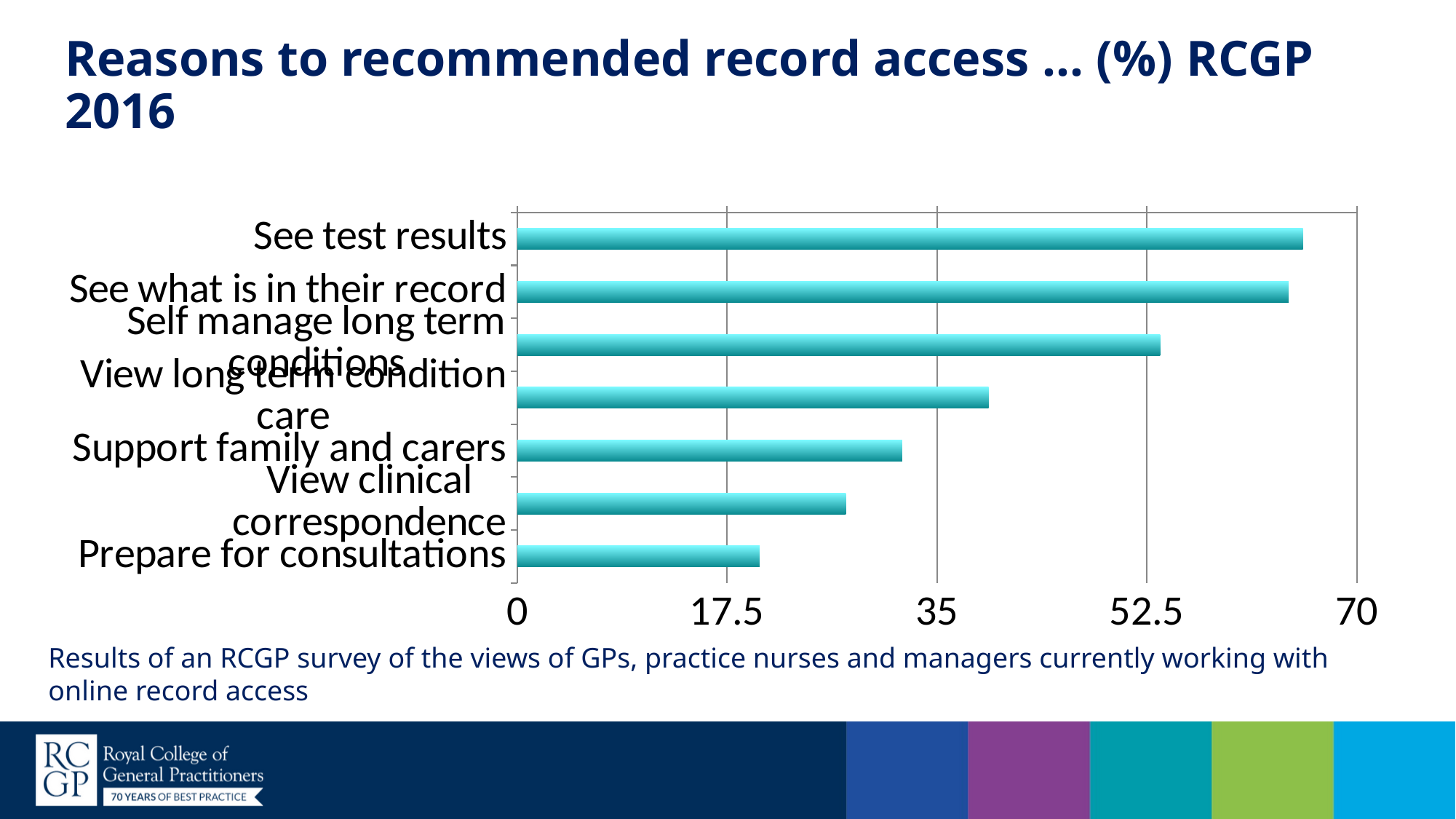
Is the value for View clinical correspondence greater or less than 35? less Is the value for See what is in their record greater or less than 52.5? greater Is the value for View long term condition care greater or less than 35? greater What kind of chart is shown on the slide? bar chart Which is larger: the value for Self manage long term conditions or the value for View clinical correspondence? Self manage long term conditions Which is larger: the value for View long term condition care or the value for Support family and carers? View long term condition care What is the highest value shown on the horizontal axis of the chart? 70 How many categories (reasons) are plotted in the chart? 7 Which reason has the lowest value in the chart? Prepare for consultations